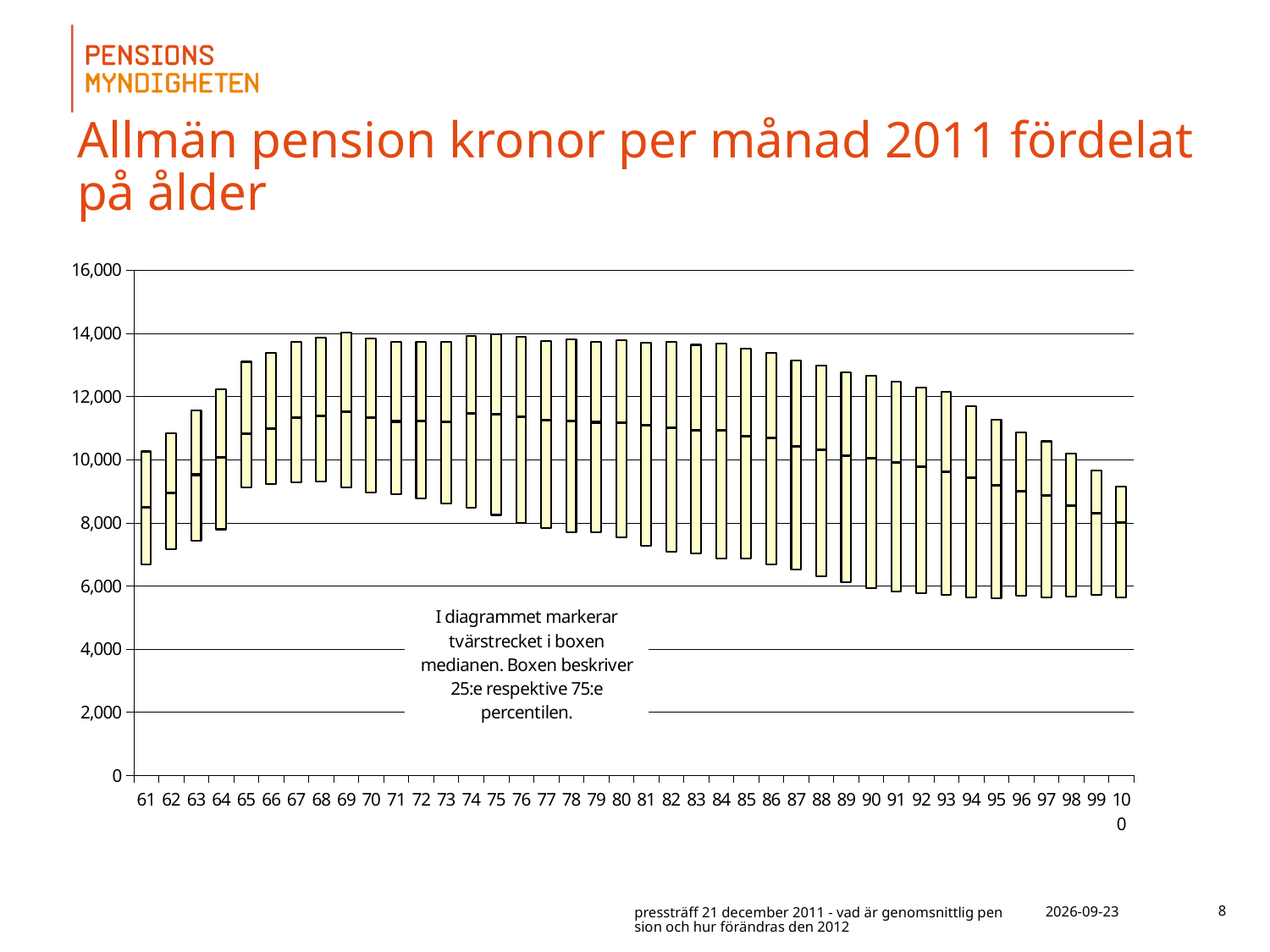
What is the highest value shown on the y axis? 16,000 What is the last age category on the x axis? 100 Is the median value for age 100 greater or less than 10,000? less What kind of chart is shown on the slide? box plot Which has the larger median value, age 61 or age 70? 70 Is the median value for age 61 greater or less than 10,000? less From age 85 to age 100, do the median values rise or fall? fall What is the first age category on the x axis? 61 Is the top of the box for age 69 greater or less than 12,000? greater How many age categories are shown along the x axis? 40 Which has the larger median value, age 65 or age 95? 65